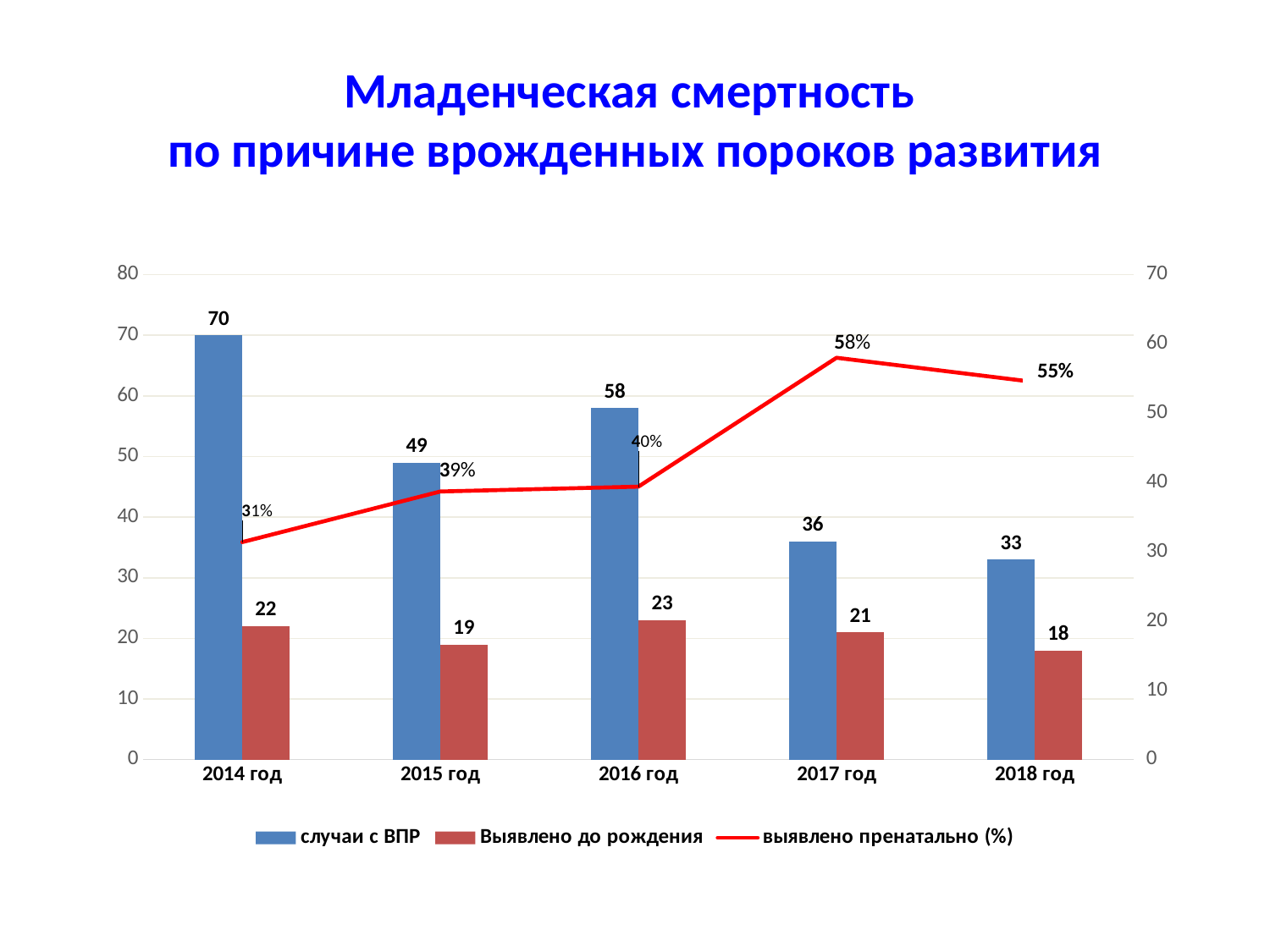
What is the difference between "случаи с ВПР" and "Выявлено до рождения" in 2015 год? 30 Which is larger: "случаи с ВПР" in 2017 год or in 2018 год? 2017 год What colour is the "выявлено пренатально (%)" line? Red Which year has the lowest value for "Выявлено до рождения"? 2018 год How many series does the legend list? 3 What kind of chart is this? Combined bar and line chart Does the "случаи с ВПР" series rise or fall from 2016 год to 2018 год? Fall What is the value of "выявлено пренатально (%)" for 2017 год? 58% How many years are shown on the x axis? 5 Which year has the highest value for "случаи с ВПР"? 2014 год What is the value of "Выявлено до рождения" for 2016 год? 23 What is the value of "случаи с ВПР" for 2014 год? 70